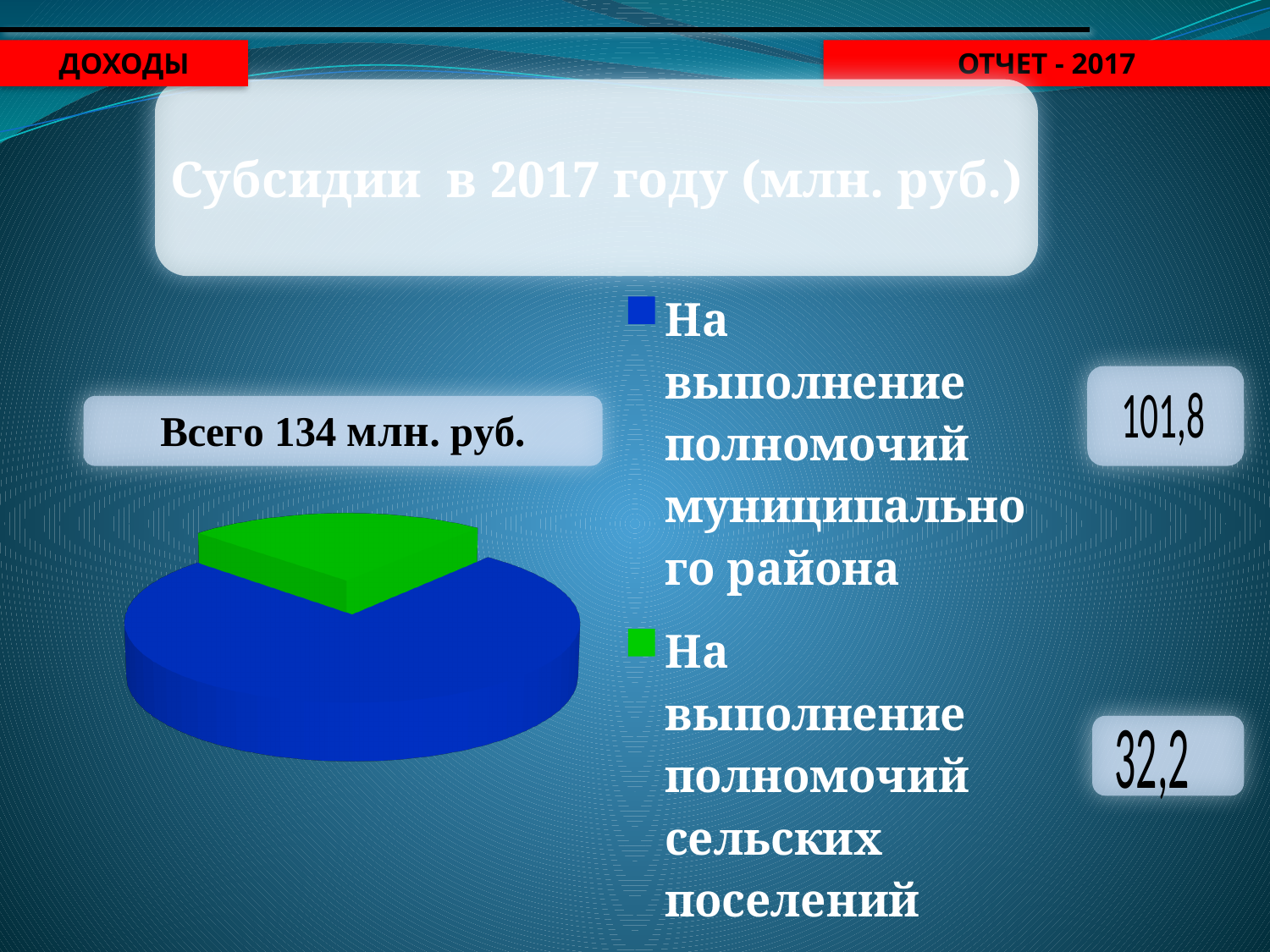
What is the difference between the value for «На выполнение полномочий муниципального района» and the value for «На выполнение полномочий сельских поселений»? 69,6 Which category has the largest slice of the pie? На выполнение полномочий муниципального района What colour is the slice for «На выполнение полномочий сельских поселений»? green What is the value for «На выполнение полномочий муниципального района»? 101,8 How many slices does the pie chart have? 2 What kind of chart is shown on the slide? pie chart Which is larger: the value for «На выполнение полномочий муниципального района» or for «На выполнение полномочий сельских поселений»? На выполнение полномочий муниципального района What is the total of all subsidies shown on the slide? 134 млн. руб. Which category has the smallest slice of the pie? На выполнение полномочий сельских поселений What is the title of the chart? Субсидии в 2017 году (млн. руб.) What is the value for «На выполнение полномочий сельских поселений»? 32,2 How many entries does the legend list? 2